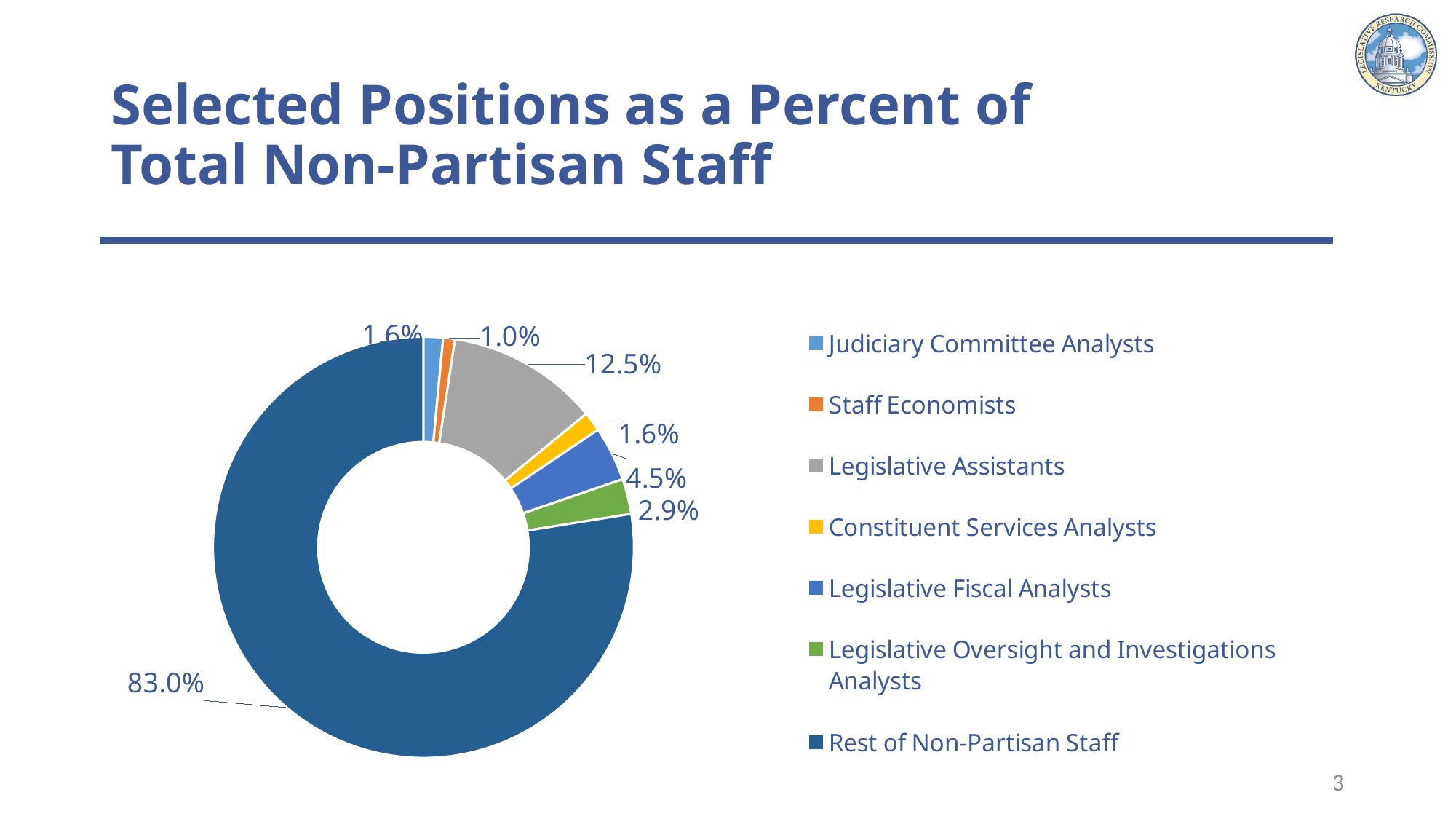
What percentage of total non-partisan staff are Legislative Oversight and Investigations Analysts? 2.9% How many categories are shown in the chart? 7 What percentage of total non-partisan staff are Legislative Fiscal Analysts? 4.5% What is the difference in percentage points between Legislative Assistants and Legislative Fiscal Analysts? 8.0 Which category has the largest share of the chart? Rest of Non-Partisan Staff What percentage of total non-partisan staff are Staff Economists? 1.0% What kind of chart is shown on the slide? Pie (doughnut) chart What share of the chart does Rest of Non-Partisan Staff represent? 83.0% What colour represents Constituent Services Analysts in the chart? Yellow Which category has the smallest share of the chart? Staff Economists Which is larger, the share for Legislative Fiscal Analysts or the share for Legislative Oversight and Investigations Analysts? Legislative Fiscal Analysts What percentage of total non-partisan staff are Legislative Assistants? 12.5%